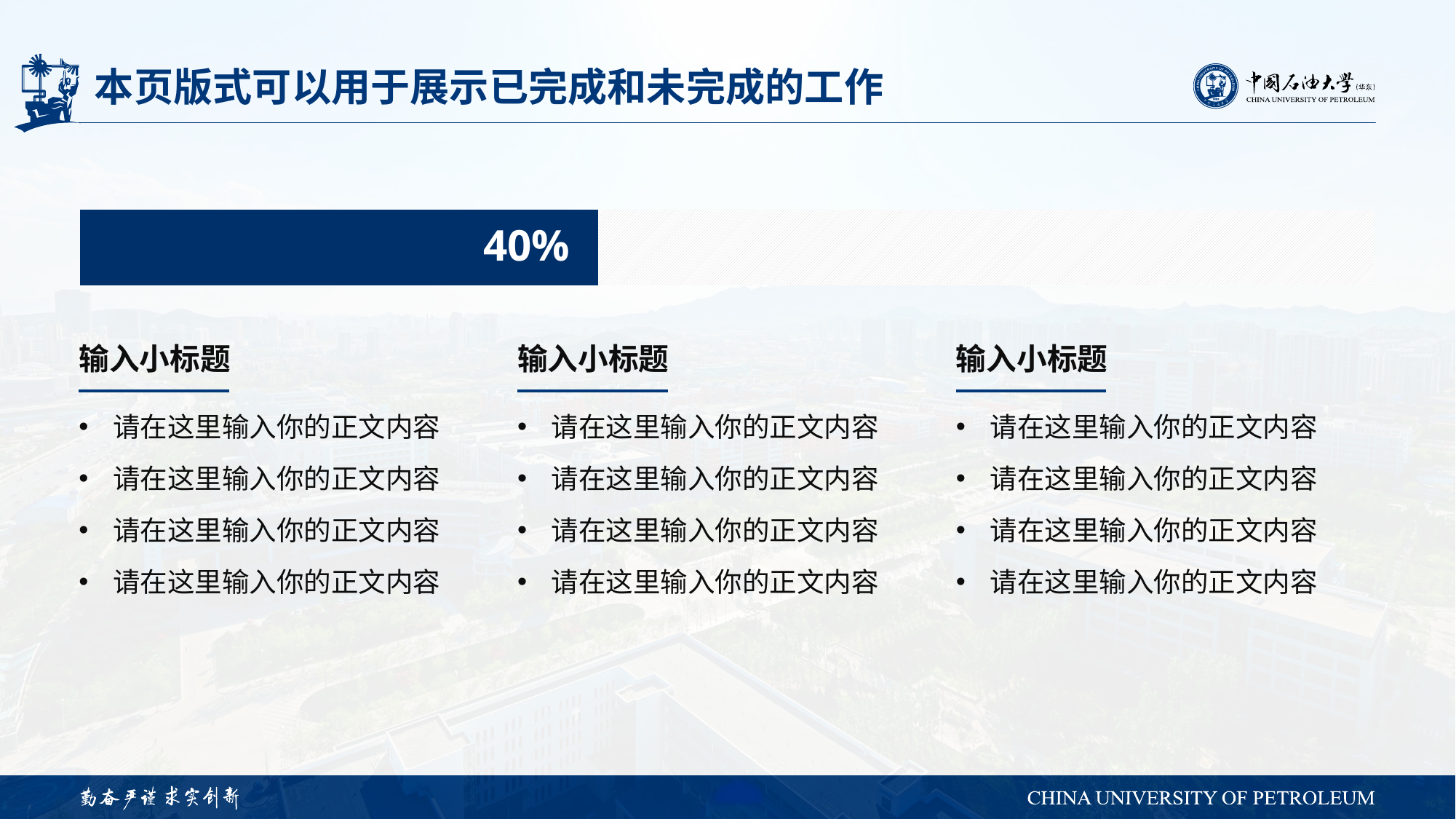
What share of the progress bar remains unfilled, given the filled portion is labelled 40%? 60% What percentage value is printed on the progress bar? 40% How many bars are shown in the progress chart? 1 Is the completed portion shown on the progress bar greater or less than 50%? less What colour is the filled (completed) portion of the progress bar? dark blue What kind of chart is used to show the completion progress on the slide? bar chart